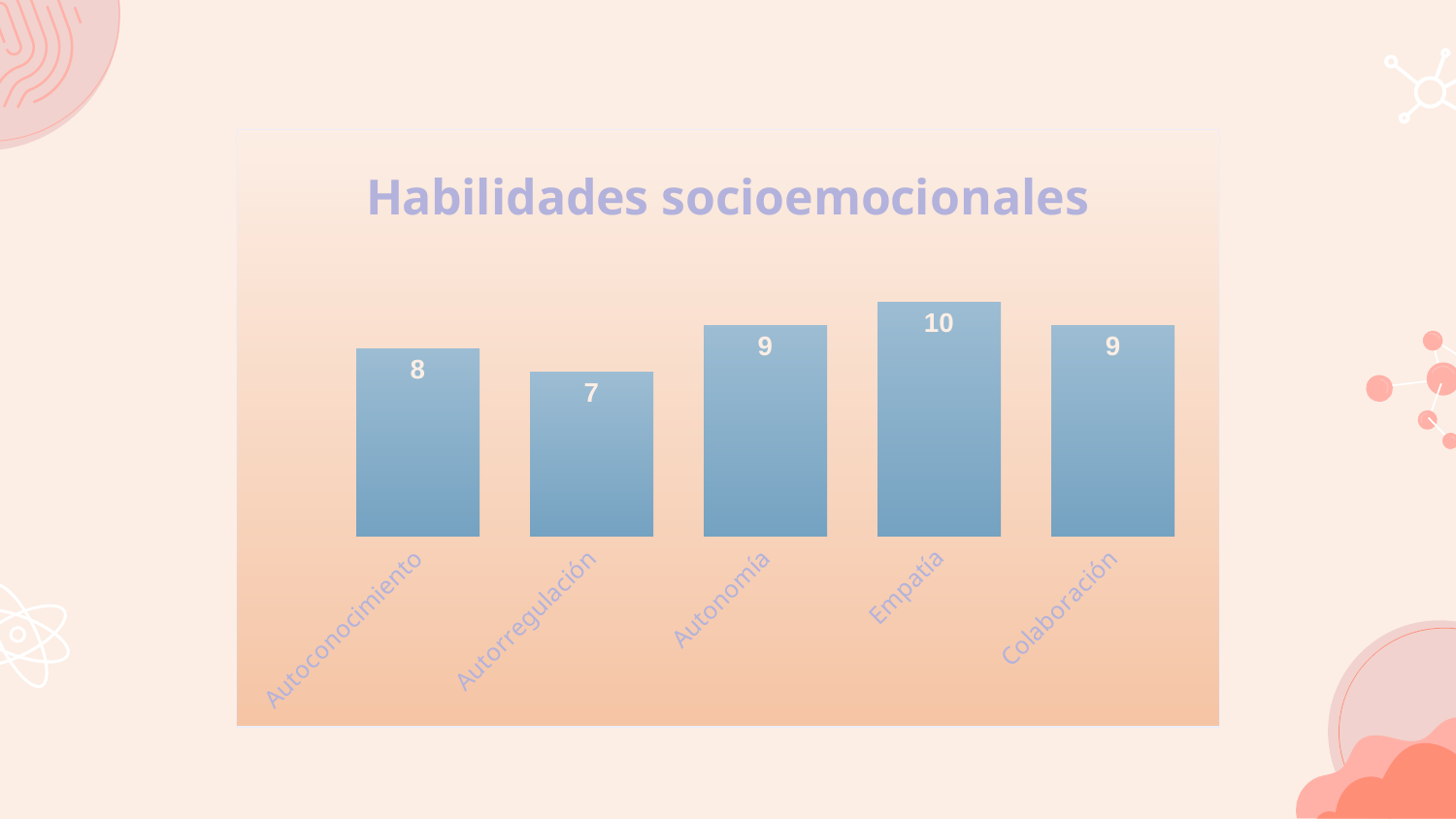
What is the difference between the values for Empatía and Autorregulación? 3 Which category has the lowest value? Autorregulación What is the value for Autoconocimiento? 8 What is the difference between the values for Autoconocimiento and Autorregulación? 1 How many categories are shown in the chart? 5 What is the value for Autorregulación? 7 What kind of chart is shown on the slide? Bar chart What is the value for Empatía? 10 What is the value for Colaboración? 9 What is the title of the chart? Habilidades socioemocionales Which category has the highest value? Empatía Which is larger, the value for Autonomía or the value for Autoconocimiento? Autonomía